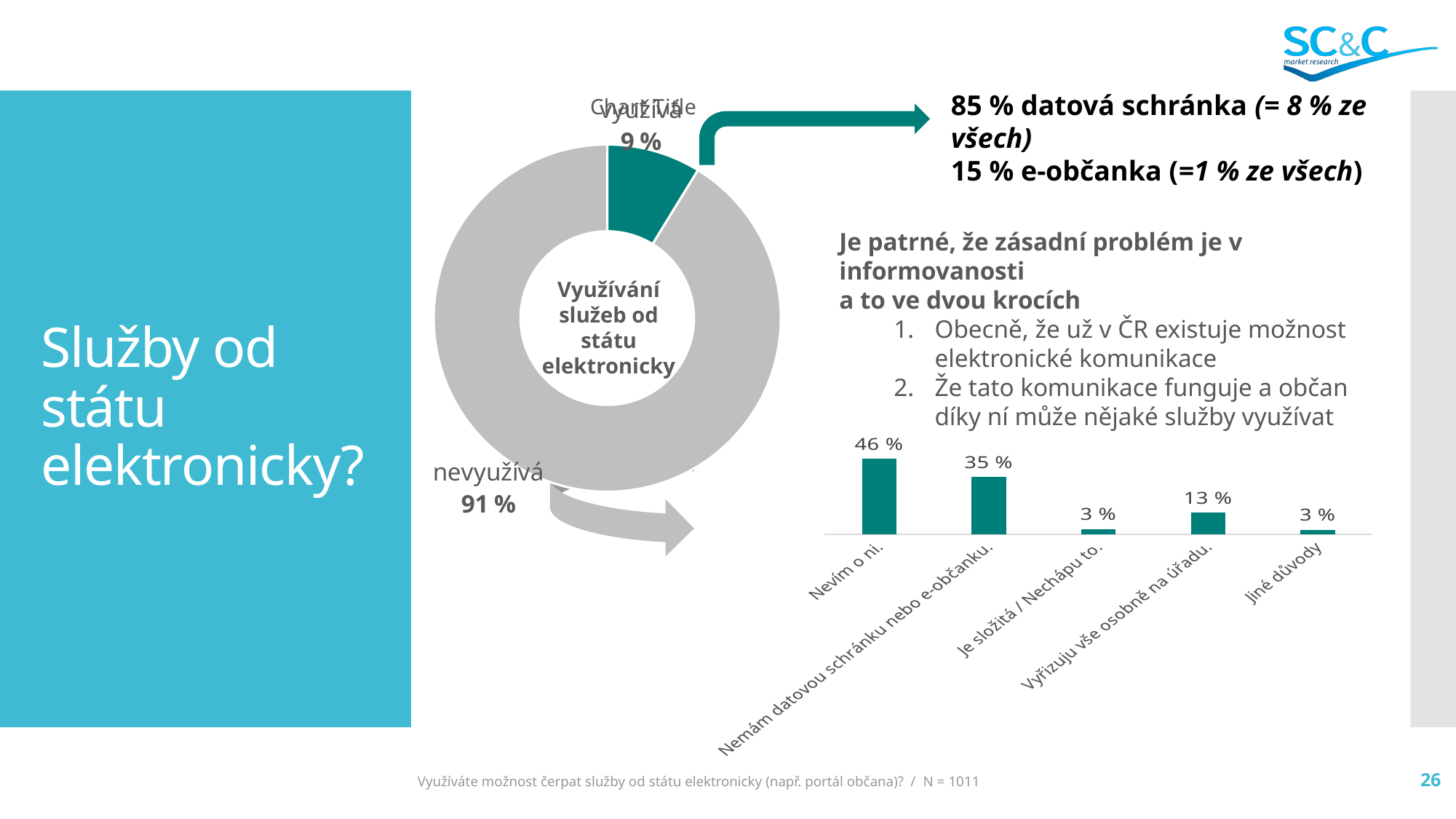
In the bar chart at the bottom right, what is the value for "Nemám datovou schránku nebo e-občanku."? 35 % In the bar chart at the bottom right, which category has the highest value? Nevím o ni. In the donut chart, what is the difference between the "nevyužívá" and "využívá" shares? 82 % What type of chart is the chart at the bottom right of the slide? Bar chart In the donut chart, what share of respondents is labelled "nevyužívá"? 91 % In the donut chart, which segment is larger, "využívá" or "nevyužívá"? nevyužívá In the donut chart, what share of respondents is labelled "využívá"? 9 % In the bar chart at the bottom right, what is the difference between "Nevím o ni." and "Nemám datovou schránku nebo e-občanku."? 11 % In the bar chart at the bottom right, how many categories are shown? 5 What type of chart is the chart on the left with the text "Využívání služeb od státu elektronicky" in its centre? Donut (pie) chart In the bar chart at the bottom right, what is the value for "Nevím o ni."? 46 % In the bar chart at the bottom right, what is the value for "Vyřizuju vše osobně na úřadu."? 13 %